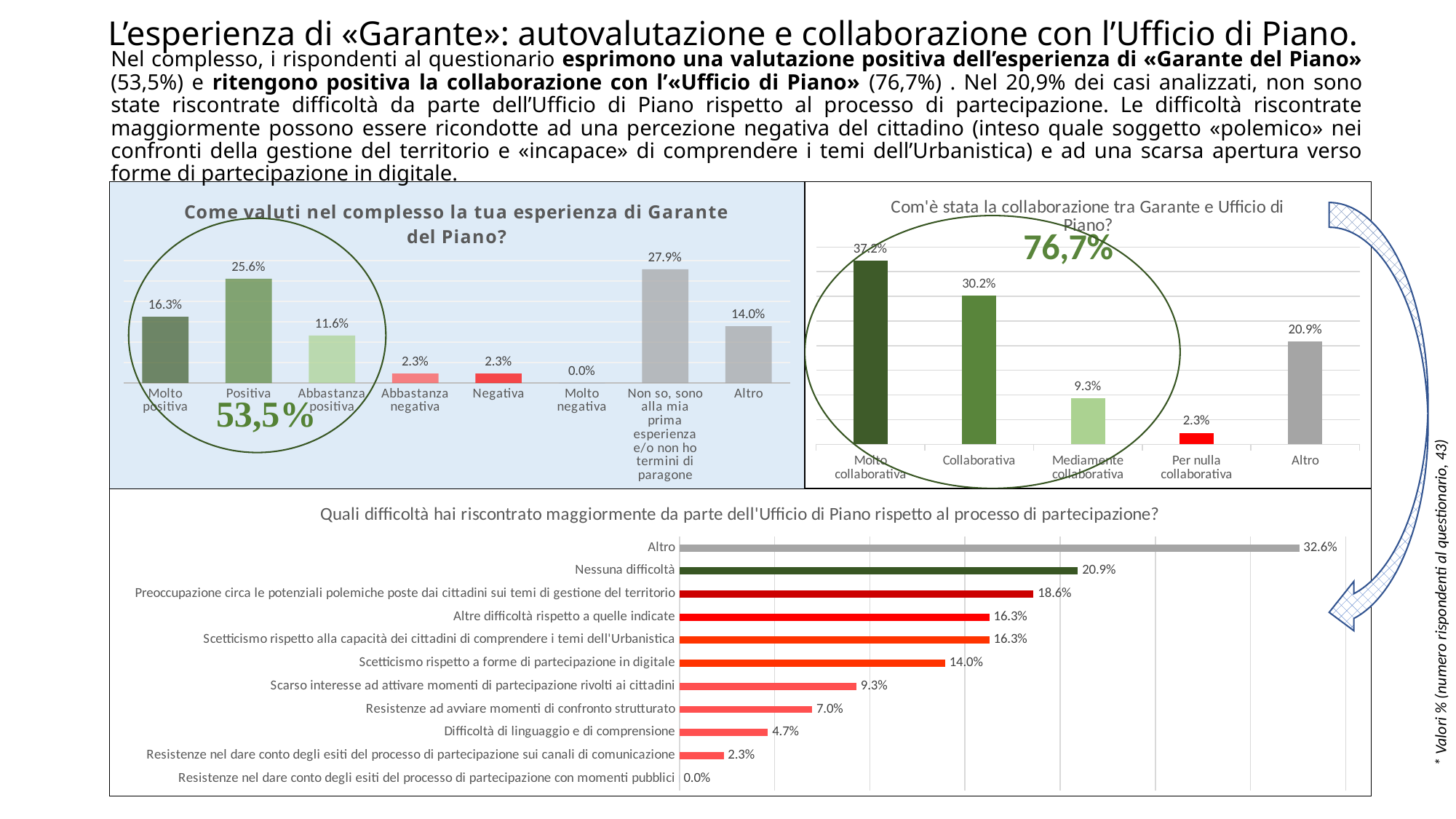
In the chart 'Com'è stata la collaborazione tra Garante e Ufficio di Piano?', which is larger: 'Collaborativa' or 'Altro'? Collaborativa In the chart 'Come valuti nel complesso la tua esperienza di Garante del Piano?', what is the difference between 'Positiva' and 'Molto positiva'? 9.3% In the chart 'Come valuti nel complesso la tua esperienza di Garante del Piano?', which category has the highest value? Non so, sono alla mia prima esperienza e/o non ho termini di paragone What kind of chart is the bottom chart 'Quali difficoltà hai riscontrato maggiormente da parte dell'Ufficio di Piano rispetto al processo di partecipazione?'? Bar chart In the chart 'Come valuti nel complesso la tua esperienza di Garante del Piano?', what is the value for 'Positiva'? 25.6% In the bottom chart 'Quali difficoltà hai riscontrato maggiormente da parte dell'Ufficio di Piano rispetto al processo di partecipazione?', what is the difference between 'Altro' and 'Scetticismo rispetto a forme di partecipazione in digitale'? 18.6% In the chart 'Com'è stata la collaborazione tra Garante e Ufficio di Piano?', what is the value for 'Mediamente collaborativa'? 9.3% In the chart 'Com'è stata la collaborazione tra Garante e Ufficio di Piano?', which category has the lowest value? Per nulla collaborativa In the bottom chart 'Quali difficoltà hai riscontrato maggiormente da parte dell'Ufficio di Piano rispetto al processo di partecipazione?', what is the value for 'Nessuna difficoltà'? 20.9% In the chart 'Come valuti nel complesso la tua esperienza di Garante del Piano?', how many categories are shown? 8 In the chart 'Com'è stata la collaborazione tra Garante e Ufficio di Piano?', how many categories are shown? 5 In the bottom chart 'Quali difficoltà hai riscontrato maggiormente da parte dell'Ufficio di Piano rispetto al processo di partecipazione?', which category has the highest value? Altro